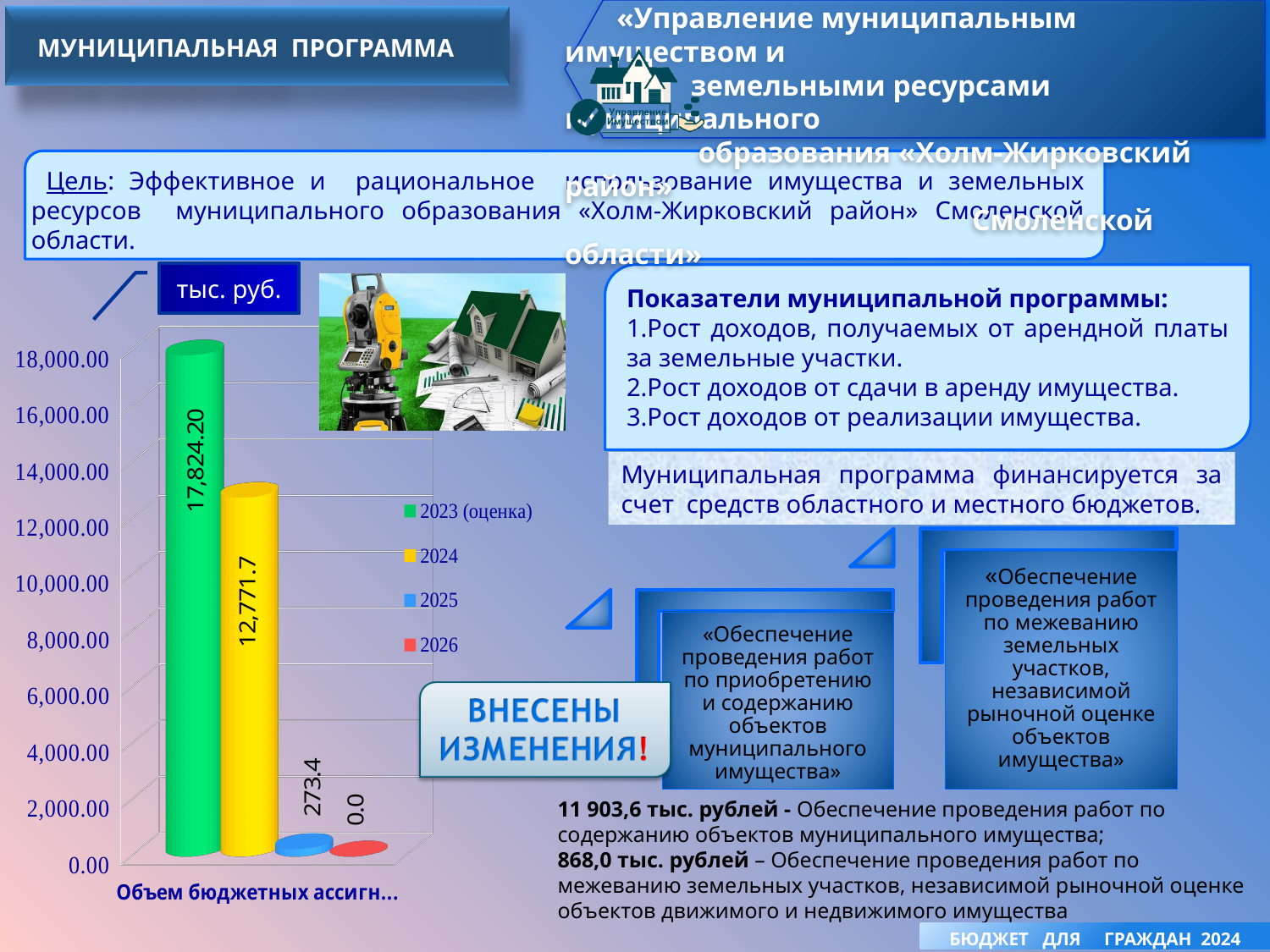
What is the value for 2024 in the bar chart? 12,771.7 What kind of chart is shown on the slide? bar chart Which series has the highest value in the bar chart? 2023 (оценка) Which is larger, the value for 2024 or the value for 2025? 2024 What is the value for 2025 in the bar chart? 273.4 Is the value for 2024 greater or less than 12,000.00? greater What is the value for 2026 in the bar chart? 0.0 How many series does the chart legend list? 4 What is the value for 2023 (оценка) in the bar chart? 17,824.20 What unit is shown in the label above the chart? тыс. руб. What is the difference between the values for 2023 (оценка) and 2024? 5,052.5 Which series has the lowest value in the bar chart? 2026